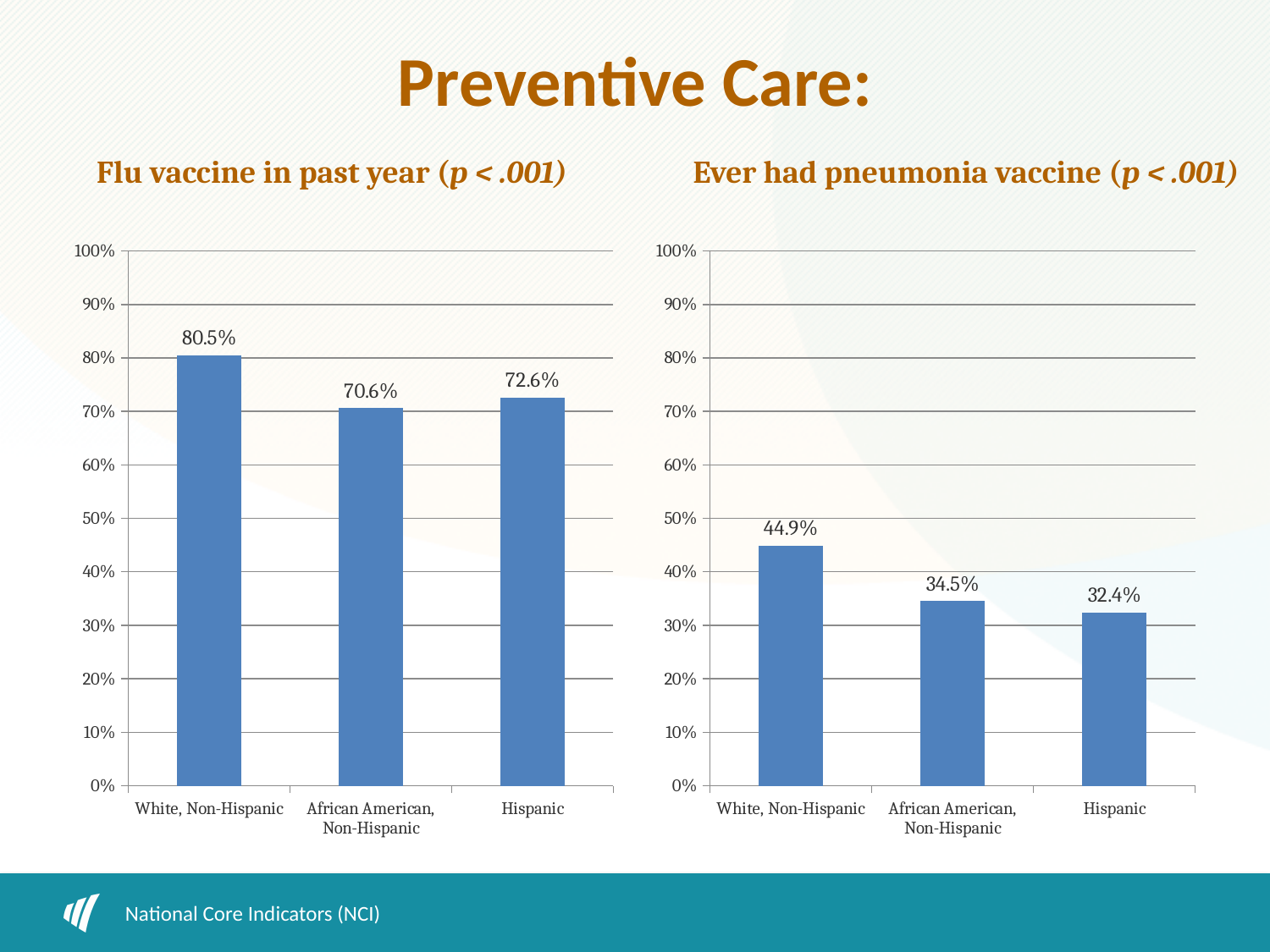
What is the main title at the top of the slide? Preventive Care: How many categories are shown in the 'Flu vaccine in past year' chart? 3 In the 'Ever had pneumonia vaccine' chart, is the value for White, Non-Hispanic greater or less than 40%? greater In the 'Ever had pneumonia vaccine' chart, do the values rise or fall from left to right across the categories? fall In the 'Flu vaccine in past year' chart, which is larger: the value for Hispanic or for African American, Non-Hispanic? Hispanic What kind of chart is the 'Ever had pneumonia vaccine' chart? bar chart In the 'Flu vaccine in past year' chart, what is the difference between the values for White, Non-Hispanic and Hispanic? 7.9% In the 'Ever had pneumonia vaccine' chart, what is the value for Hispanic? 32.4% In the 'Ever had pneumonia vaccine' chart, what is the difference between the values for White, Non-Hispanic and African American, Non-Hispanic? 10.4% In the 'Flu vaccine in past year' chart, what is the value for White, Non-Hispanic? 80.5% In the 'Ever had pneumonia vaccine' chart, which category has the highest value? White, Non-Hispanic In the 'Flu vaccine in past year' chart, which category has the lowest value? African American, Non-Hispanic